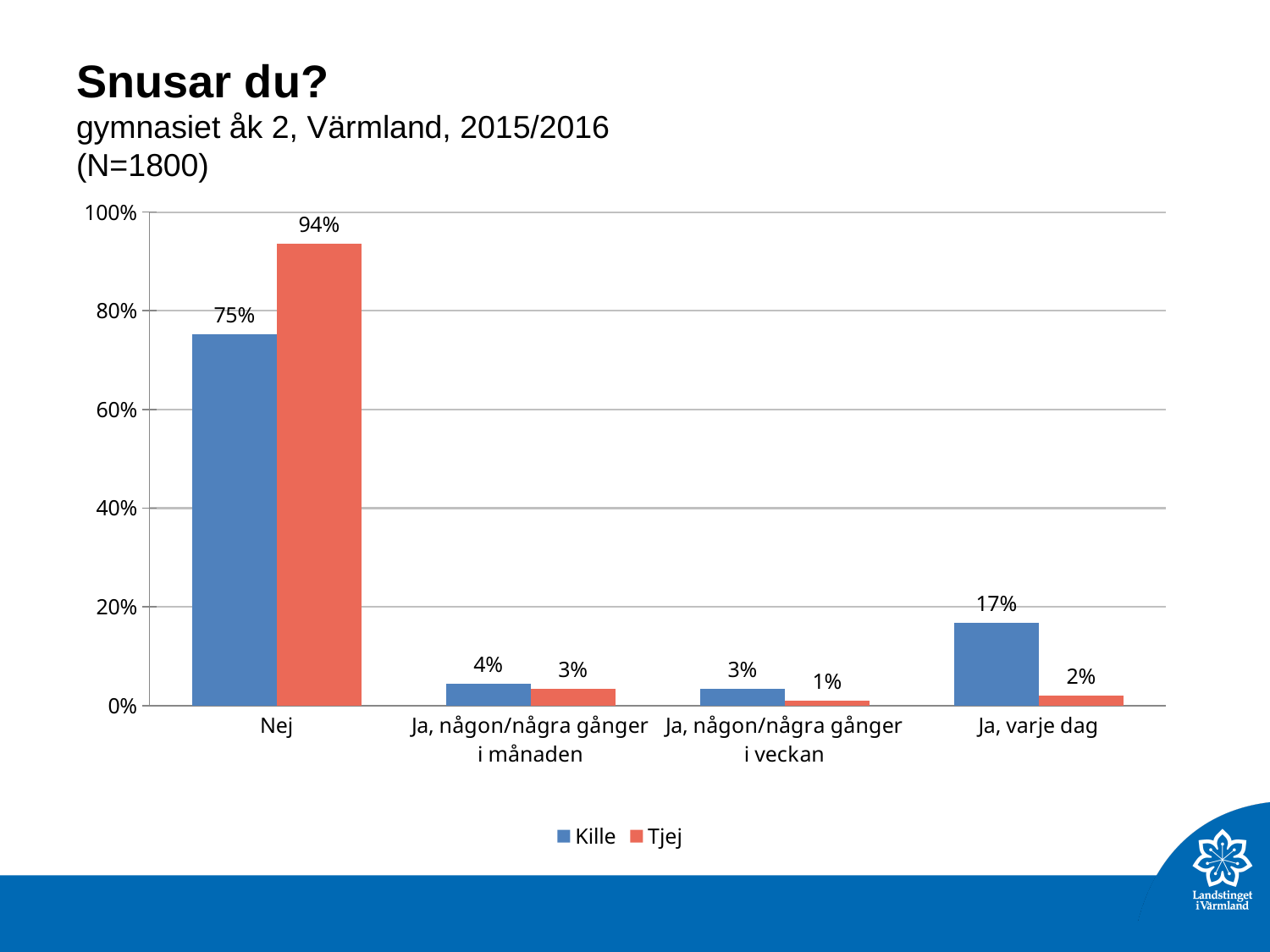
Which category has the highest value for Tjej? Nej What is the value for Tjej in the Nej category? 94% What is the difference between the Tjej and Kille values in the Nej category? 19% In the Ja, varje dag category, which series has the larger value, Kille or Tjej? Kille What is the value for Kille in the Ja, varje dag category? 17% How many categories are shown on the x axis? 4 How many series does the legend list? 2 What is the value for Kille in the Nej category? 75% Which category has the lowest value for Tjej? Ja, någon/några gånger i veckan What is the difference between the Kille and Tjej values in the Ja, varje dag category? 15% What kind of chart is shown on the slide? Bar chart What is the value for Tjej in the Ja, någon/några gånger i veckan category? 1%